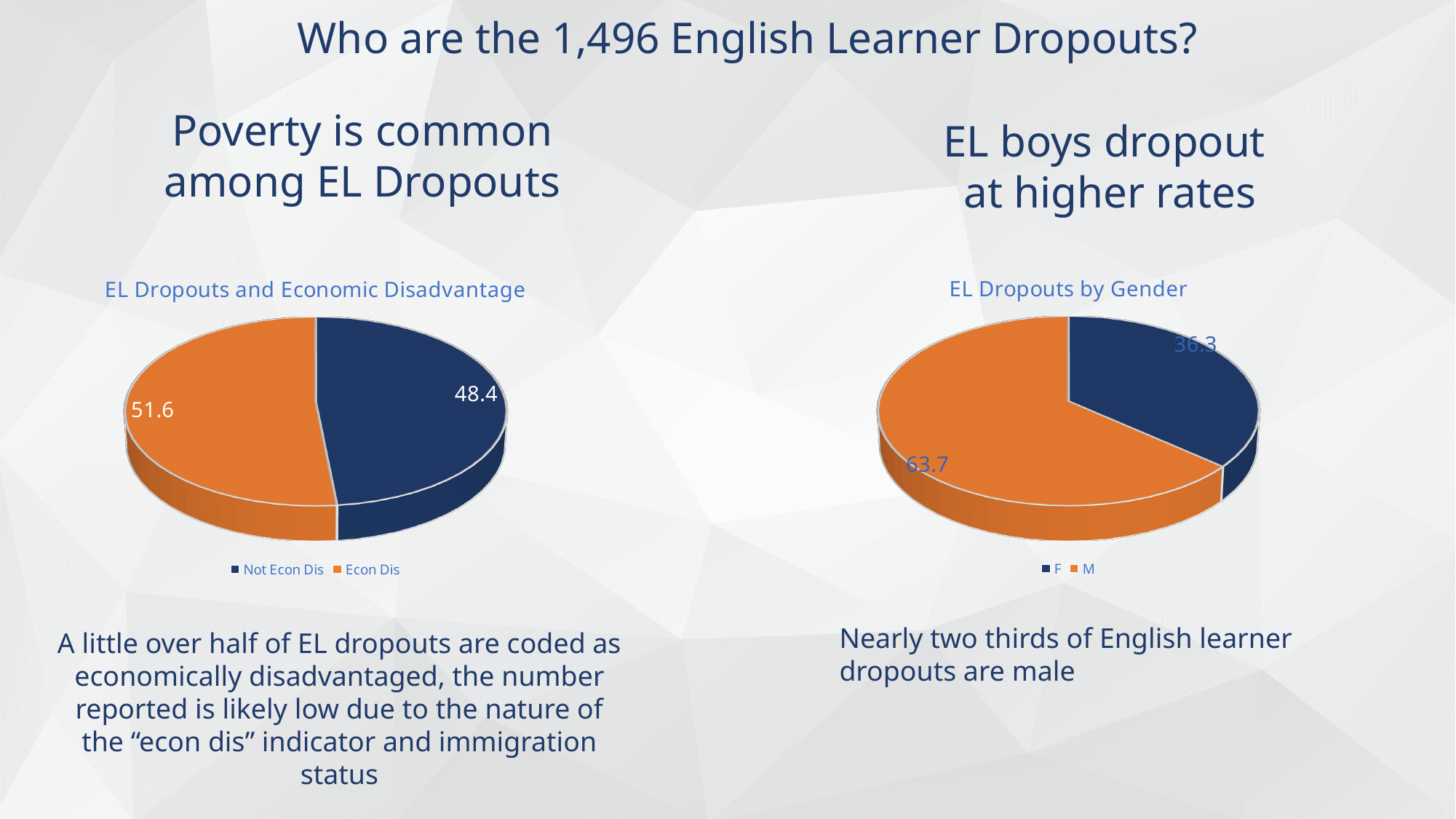
In the 'EL Dropouts by Gender' chart, what colour is the M slice? Orange In the 'EL Dropouts by Gender' chart, which is larger, F or M? M In the 'EL Dropouts by Gender' chart, what is the value for M? 63.7 In the 'EL Dropouts and Economic Disadvantage' chart, what is the difference between the Econ Dis and Not Econ Dis values? 3.2 In the 'EL Dropouts by Gender' chart, what is the difference between the M and F values? 27.4 In the 'EL Dropouts by Gender' chart, which category has the largest slice? M What kind of chart is 'EL Dropouts by Gender'? Pie chart How many categories does the 'EL Dropouts and Economic Disadvantage' chart show? 2 In the 'EL Dropouts and Economic Disadvantage' chart, what is the value for Econ Dis? 51.6 In the 'EL Dropouts by Gender' chart, what is the value for F? 36.3 In the 'EL Dropouts and Economic Disadvantage' chart, which category has the smaller slice? Not Econ Dis In the 'EL Dropouts and Economic Disadvantage' chart, what is the value for Not Econ Dis? 48.4